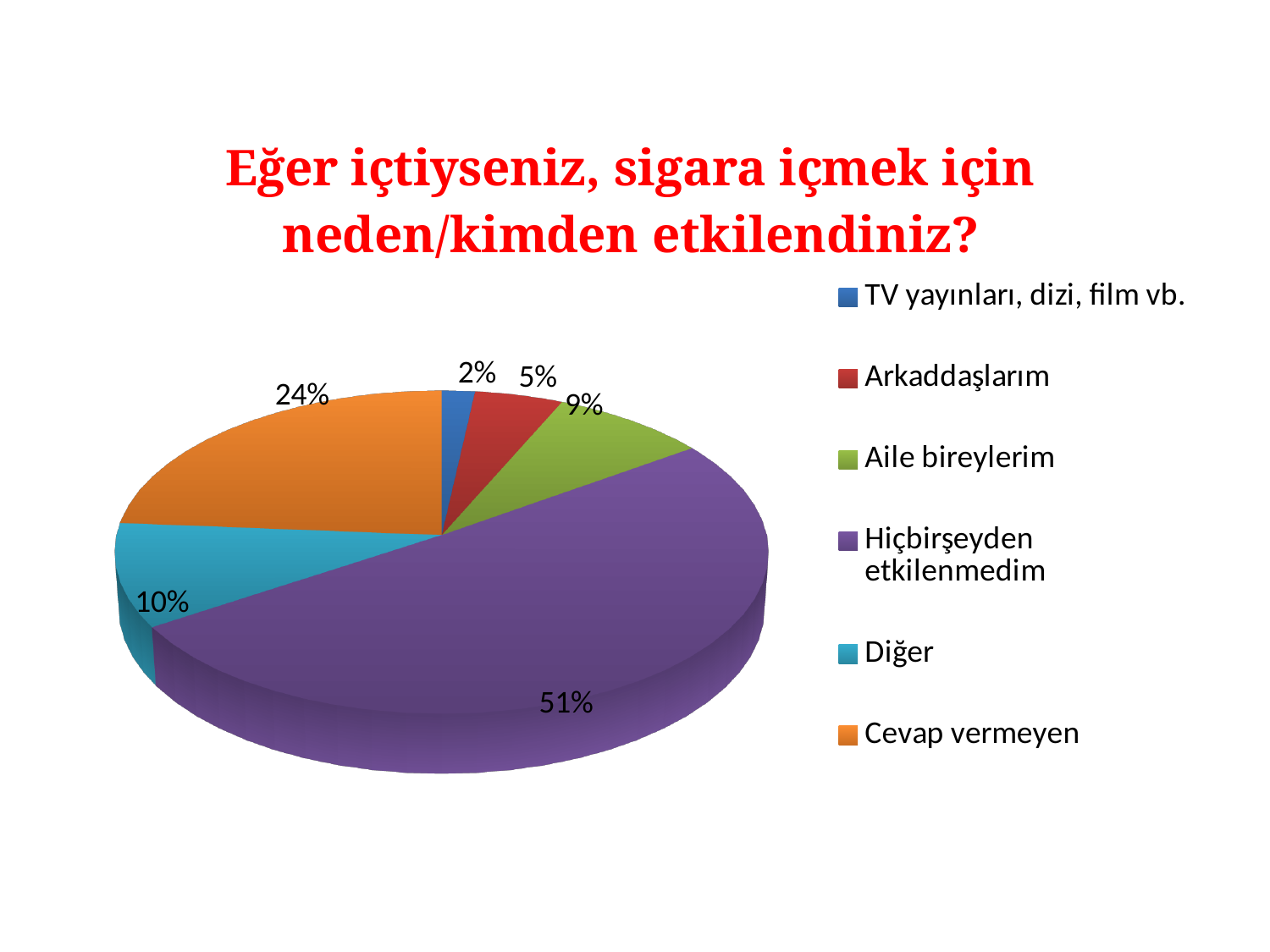
What share of the pie does "Hiçbirşeyden etkilenmedim" have? 51% Which is larger, the value for "Arkaddaşlarım" or the value for "Aile bireylerim"? Aile bireylerim What is the difference between the values for "Cevap vermeyen" and "Diğer"? 14% Which category has the largest slice of the pie? Hiçbirşeyden etkilenmedim Which category has the smallest slice of the pie? TV yayınları, dizi, film vb. What is the value for "Diğer"? 10% What colour is the slice for "Cevap vermeyen"? Orange What is the value for "TV yayınları, dizi, film vb."? 2% How many categories does the legend list? 6 What is the value for "Aile bireylerim"? 9% What kind of chart is shown on the slide? Pie chart What is the value for "Cevap vermeyen"? 24%